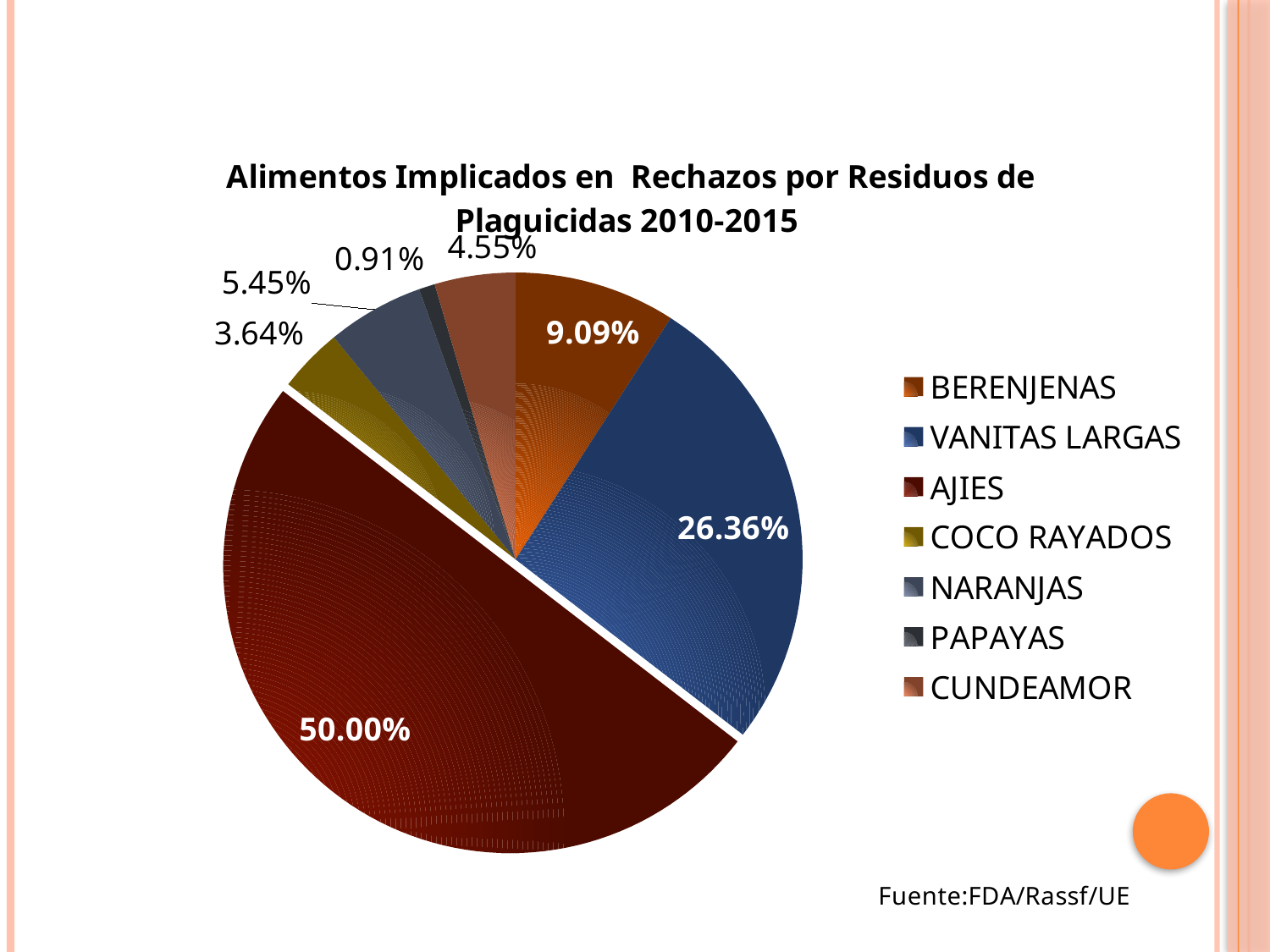
Which category has the smallest slice of the pie? PAPAYAS What is the share for NARANJAS? 5.45% Which category has the largest slice of the pie? AJIES What is the difference between the shares of AJIES and VANITAS LARGAS? 23.64% What is the share for VANITAS LARGAS? 26.36% What is the title of the chart? Alimentos Implicados en Rechazos por Residuos de Plaguicidas 2010-2015 Which is larger, the share for CUNDEAMOR or the share for COCO RAYADOS? CUNDEAMOR What kind of chart is shown on the slide? pie chart What is the share for BERENJENAS? 9.09% What is the share for AJIES? 50.00% What is the share for PAPAYAS? 0.91% How many categories does the legend list? 7